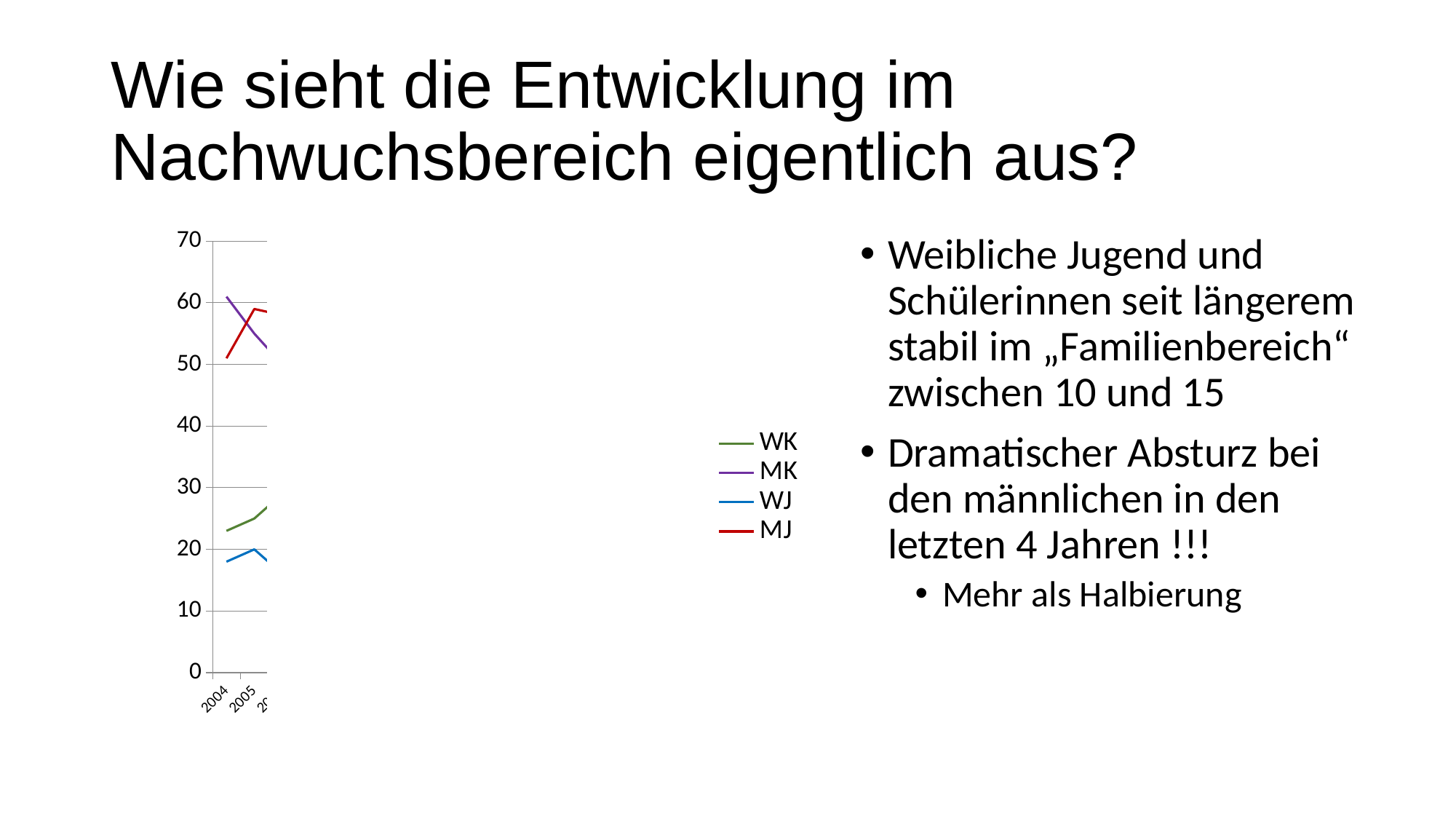
In 2004, which is larger, the value for MK or the value for MJ? MK What are the series names listed in the chart's legend? WK, MK, WJ, MJ Is the value for MK in 2004 greater or less than 50? greater What colour is the MJ line in the chart? red How many series does the chart's legend list? 4 What kind of chart is shown on the slide? line chart Is the value for MJ in 2005 greater or less than 50? greater Which series has the highest value in 2004? MK Which series has the lowest value in 2004? WJ Is the value for WJ in 2004 greater or less than 20? less Does the MK line rise or fall from 2004 to 2005? fall